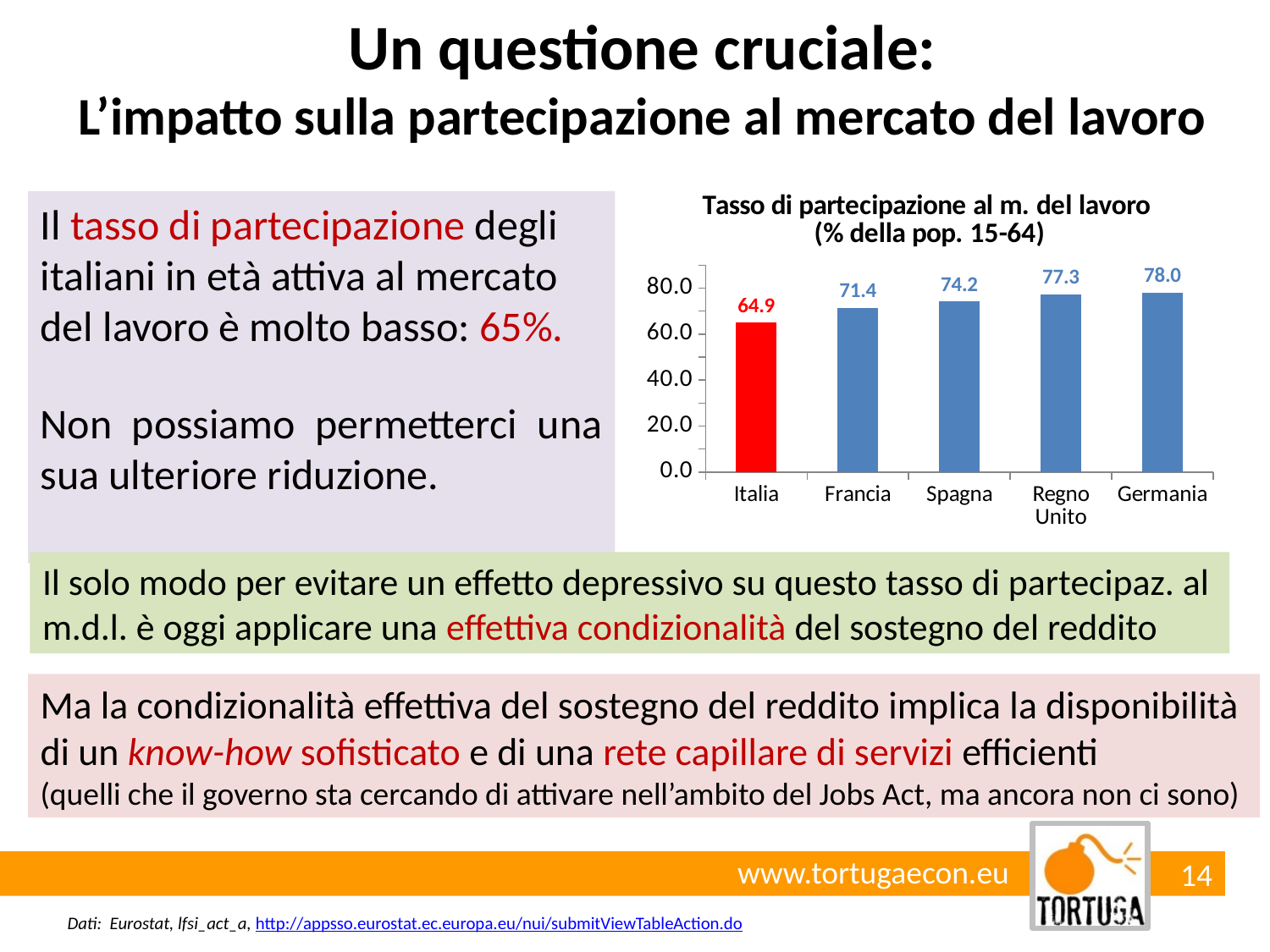
Which bar in the chart is coloured red? Italia Is the value for Italia greater or less than 60.0? greater Which country has the highest participation rate in the chart? Germania What is the difference between the values for Spagna and Francia? 2.8 What is the value for Italia in the chart? 64.9 What is the value for Germania in the chart? 78.0 What is the value for Regno Unito in the chart? 77.3 What kind of chart is shown on the slide? bar chart Which country has the lowest participation rate in the chart? Italia Which is larger, the value for Francia or the value for Spagna? Spagna How many countries are shown in the chart? 5 What is the difference between the values for Germania and Italia? 13.1